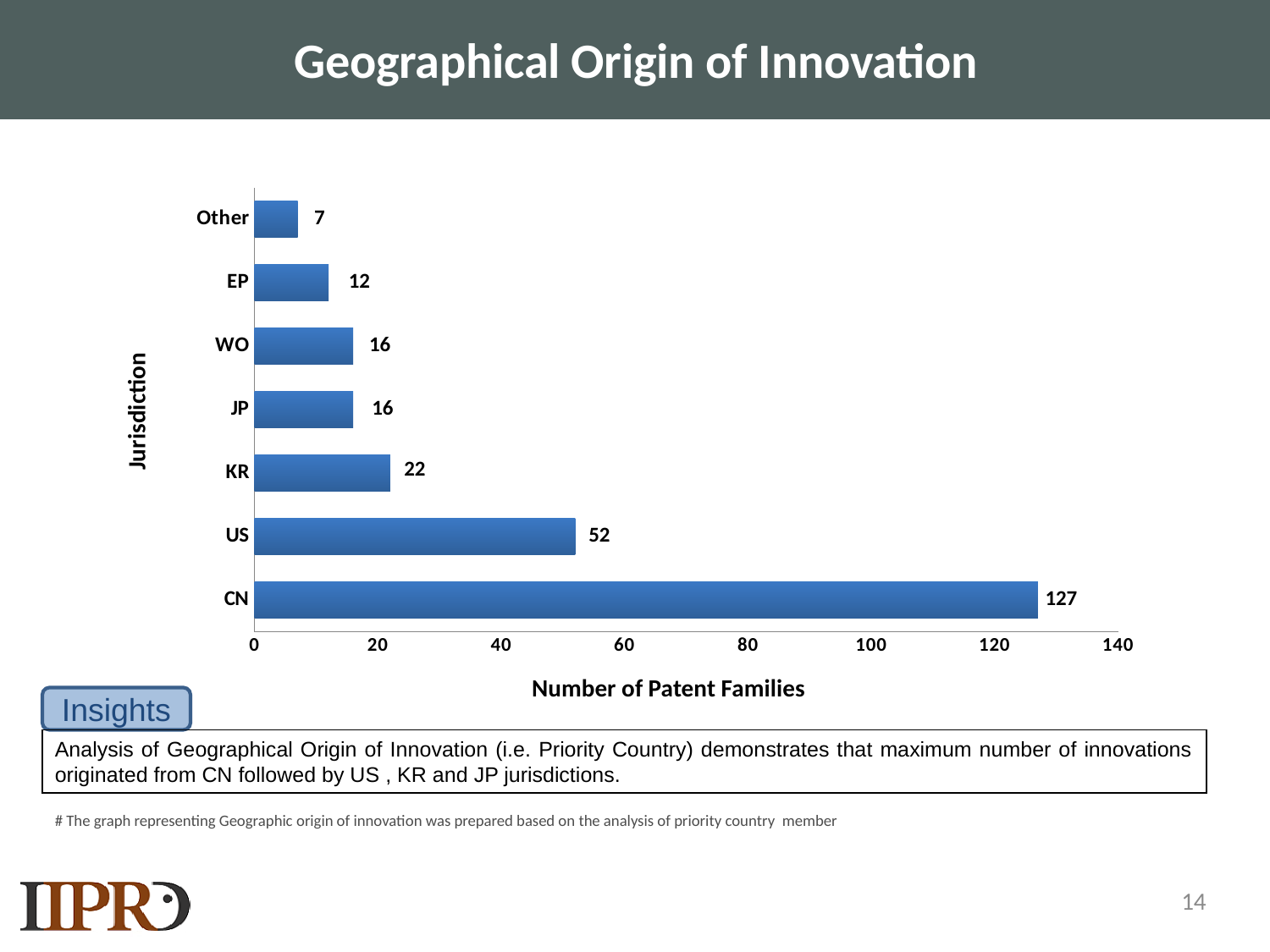
What is the number of patent families for US? 52 What is the number of patent families for CN? 127 What kind of chart is shown on the slide? Bar chart Which has more patent families, KR or WO? KR What is the number of patent families for KR? 22 What is the number of patent families for EP? 12 Is the value for US greater or less than 40? greater How many jurisdictions are shown in the chart? 7 Which jurisdiction has the highest number of patent families? CN What is the difference in number of patent families between CN and US? 75 Which jurisdiction has the lowest number of patent families? Other What is the label of the horizontal axis of the chart? Number of Patent Families